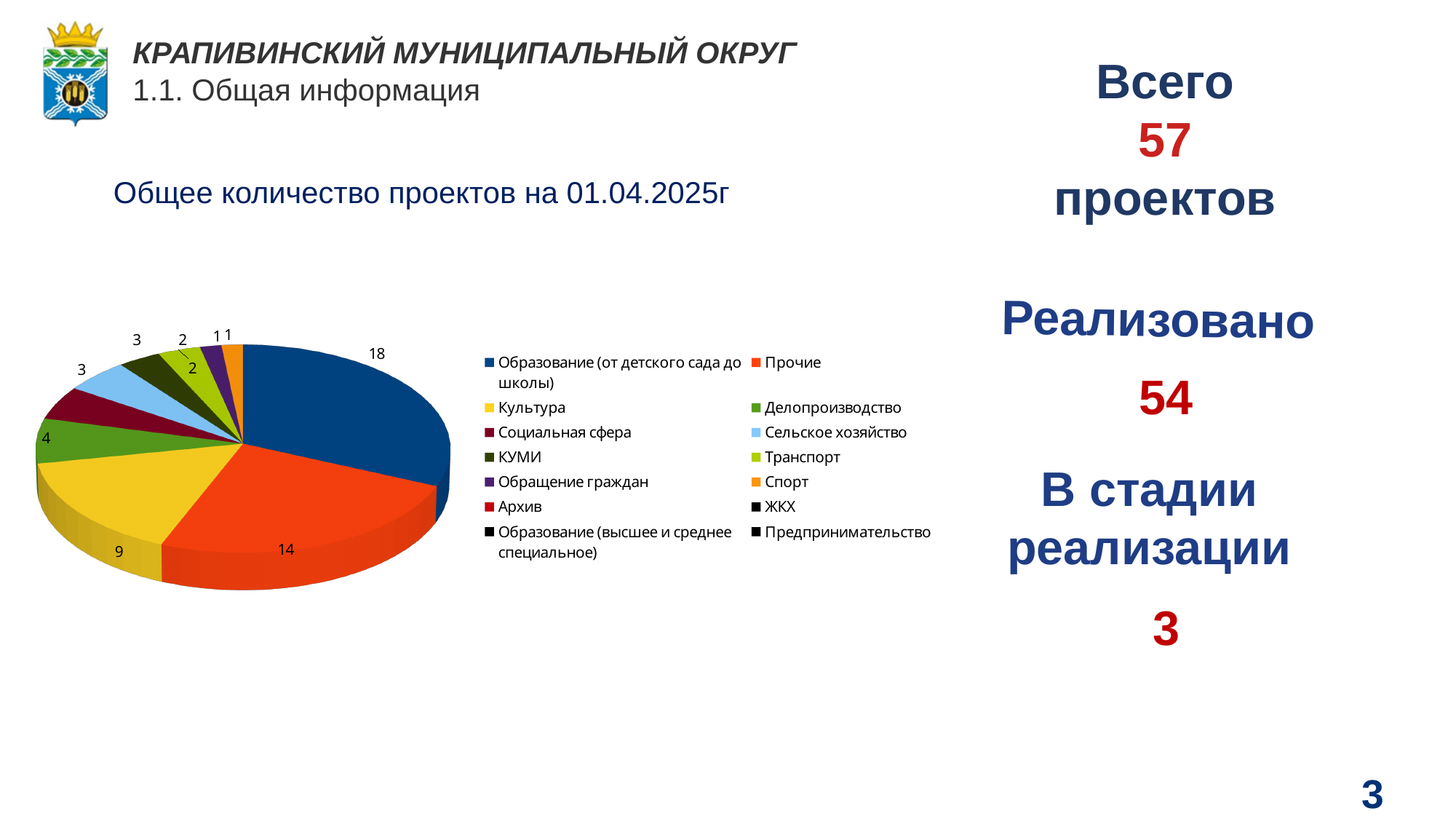
What is the value of the Прочие slice? 14 Which is larger, the Культура slice or the Прочие slice? Прочие What colour is the Культура slice in the pie chart? yellow What is the difference between the Образование (от детского сада до школы) slice and the Прочие slice? 4 What is the title above the pie chart? Общее количество проектов на 01.04.2025г Which category has the largest slice in the pie chart? Образование (от детского сада до школы) How many entries does the legend of the pie chart list? 14 What is the value of the Культура slice? 9 What is the difference between the Культура slice and the Делопроизводство slice? 5 What is the value of the Делопроизводство slice? 4 What is the value of the Образование (от детского сада до школы) slice? 18 What kind of chart is shown on the slide? pie chart